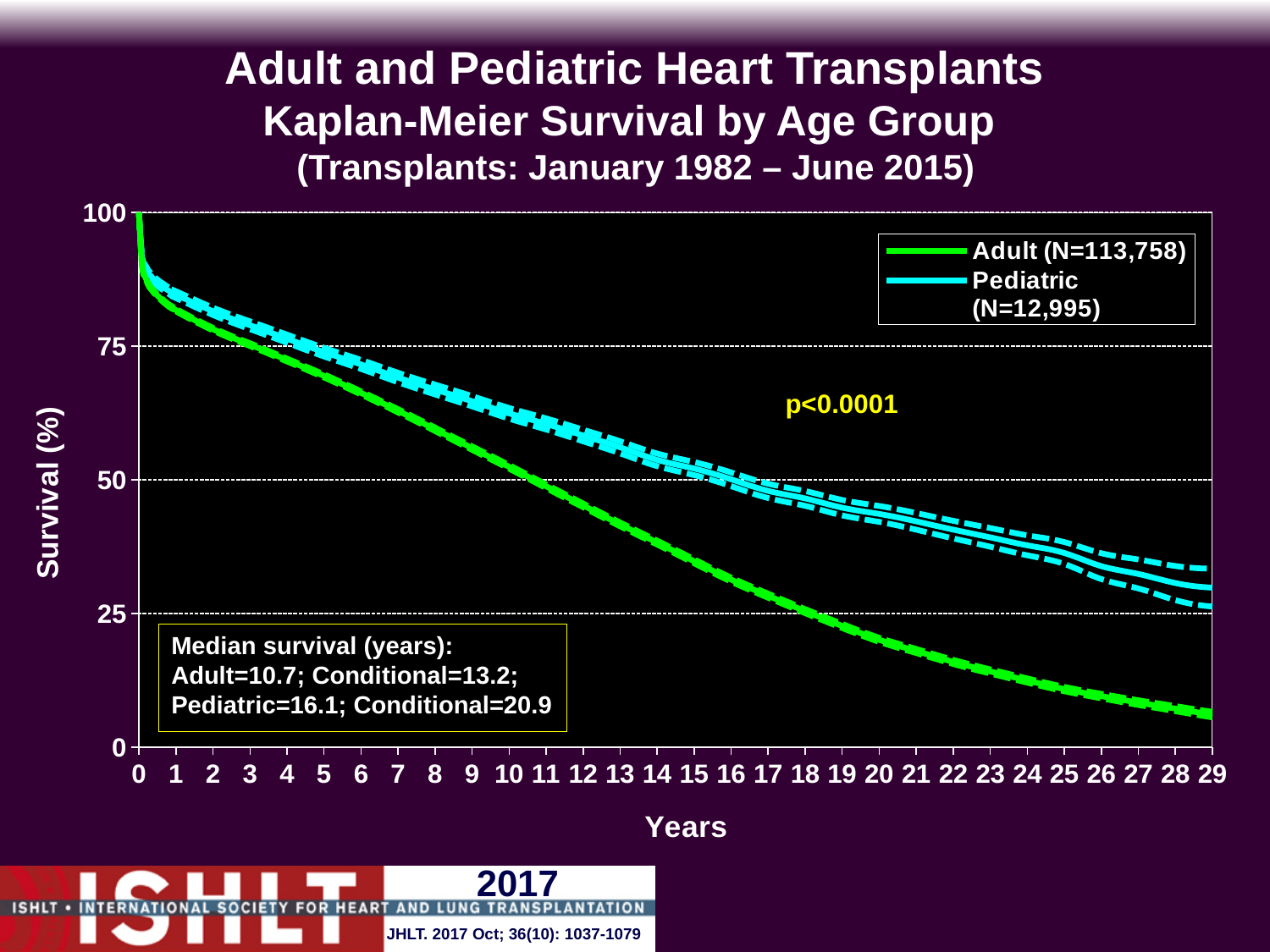
Is the Pediatric survival at 10 years greater or less than 50? greater What is the median survival in years for Adult recipients, as printed on the slide? 10.7 Do the survival curves rise or fall as years increase? fall What is the conditional median survival in years for Adult recipients? 13.2 How many series does the legend list? 2 Which series has higher survival at 15 years, Adult or Pediatric? Pediatric What is the conditional median survival in years for Pediatric recipients? 20.9 What is the median survival in years for Pediatric recipients, as printed on the slide? 16.1 Is the Adult survival at 20 years greater or less than 25? less What p-value is printed on the chart? p<0.0001 What is the N for the Adult series shown in the legend? 113,758 What kind of chart is shown on the slide? line chart